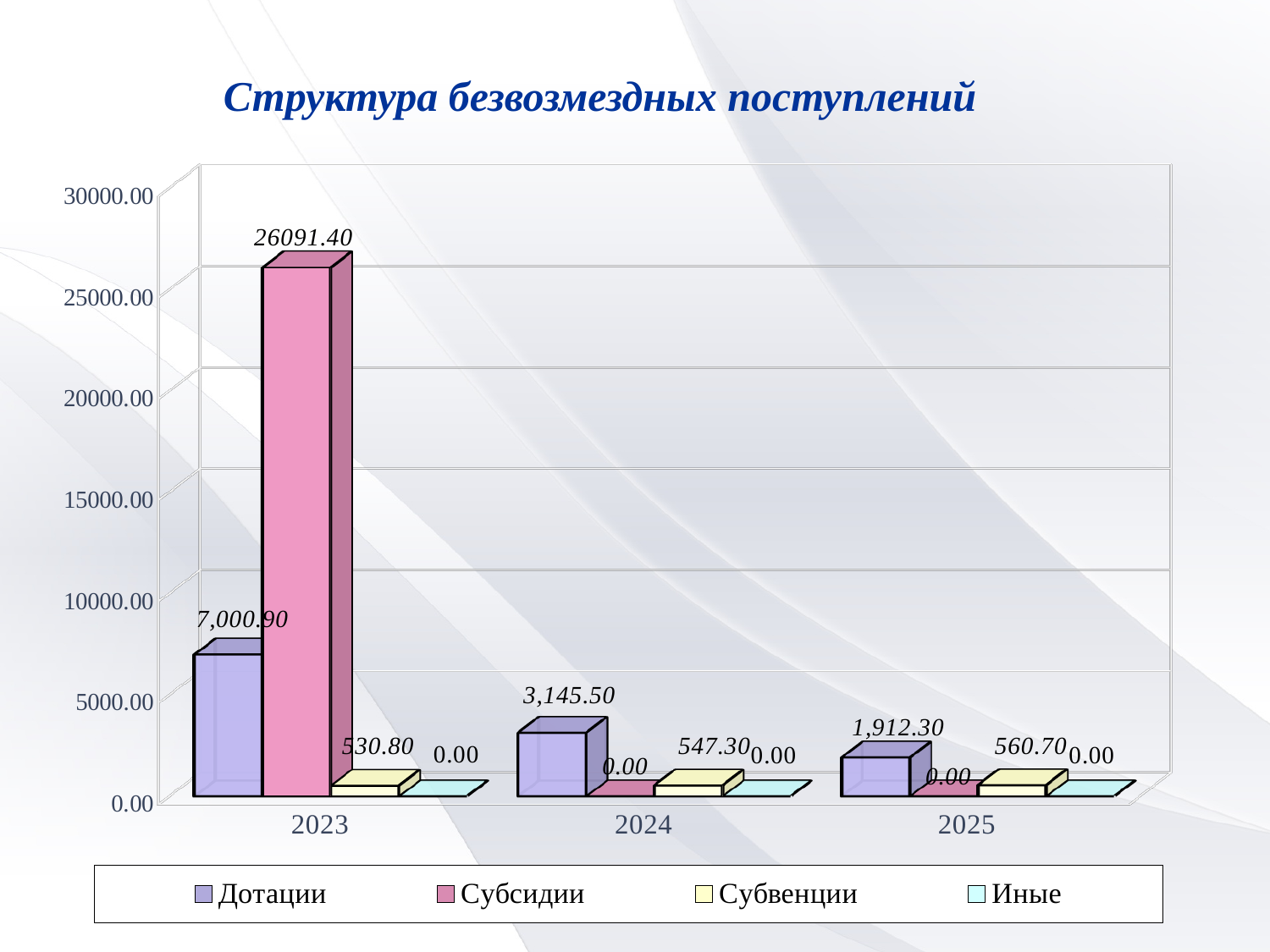
In which year is the value for Дотации the highest? 2023 Is the value for Субсидии in 2023 greater or less than 25000.00? greater What kind of chart is shown on the slide? bar chart What is the value for Иные in 2023? 0.00 How many years are shown on the x axis? 3 In which year is the value for Дотации the lowest? 2025 What is the difference between the Дотации values for 2023 and 2024? 3,855.40 What is the value for Субвенции in 2025? 560.70 How many series does the legend list? 4 What is the value for Дотации in 2024? 3,145.50 What is the value for Субсидии in 2023? 26091.40 Which is larger in 2023: Дотации or Субсидии? Субсидии